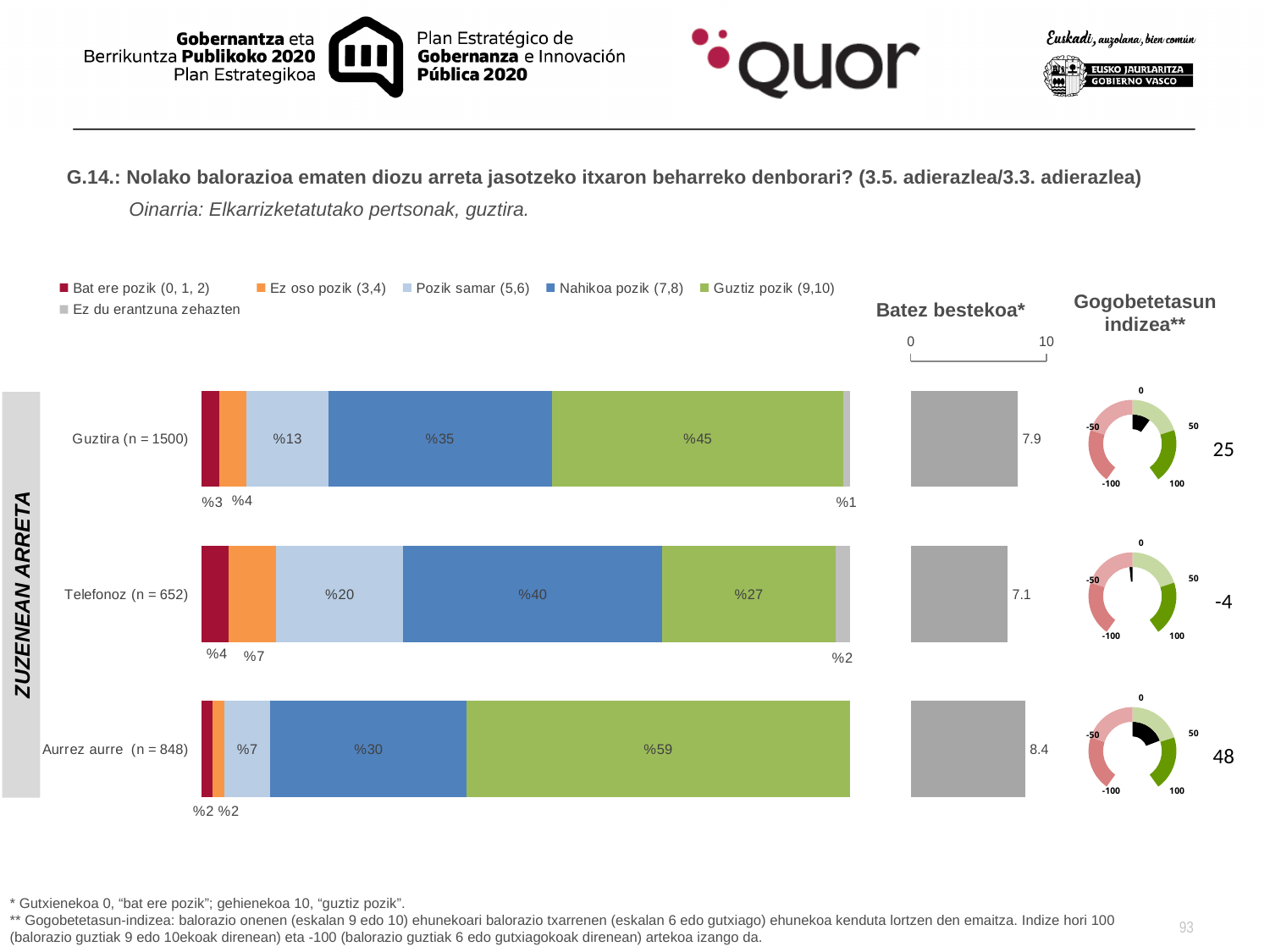
In the stacked bar chart, what is the difference in the 'Guztiz pozik (9,10)' share between 'Aurrez aurre (n = 848)' and 'Telefonoz (n = 652)'? 32 percentage points In the 'Batez bestekoa*' chart, what is the average value for 'Aurrez aurre (n = 848)'? 8.4 What kind of chart is used to show the satisfaction distribution on the slide? Stacked bar chart In the stacked bar chart, is the 'Pozik samar (5,6)' share larger for 'Telefonoz (n = 652)' or for 'Guztira (n = 1500)'? Telefonoz (n = 652) In the stacked bar chart, what percentage of 'Guztira (n = 1500)' respondents answered 'Guztiz pozik (9,10)'? %45 How many series does the legend of the stacked bar chart list? 6 In the stacked bar chart, which category has the highest share of 'Guztiz pozik (9,10)'? Aurrez aurre (n = 848) In the stacked bar chart, what percentage of 'Telefonoz (n = 652)' respondents answered 'Nahikoa pozik (7,8)'? %40 How many categories (rows) are shown in the stacked bar chart? 3 In the stacked bar chart, which category has the lowest share of 'Guztiz pozik (9,10)'? Telefonoz (n = 652) In the 'Gogobetetasun indizea**' gauges, what is the index value for 'Telefonoz (n = 652)'? -4 In the stacked bar chart, what percentage of 'Aurrez aurre (n = 848)' respondents answered 'Pozik samar (5,6)'? %7